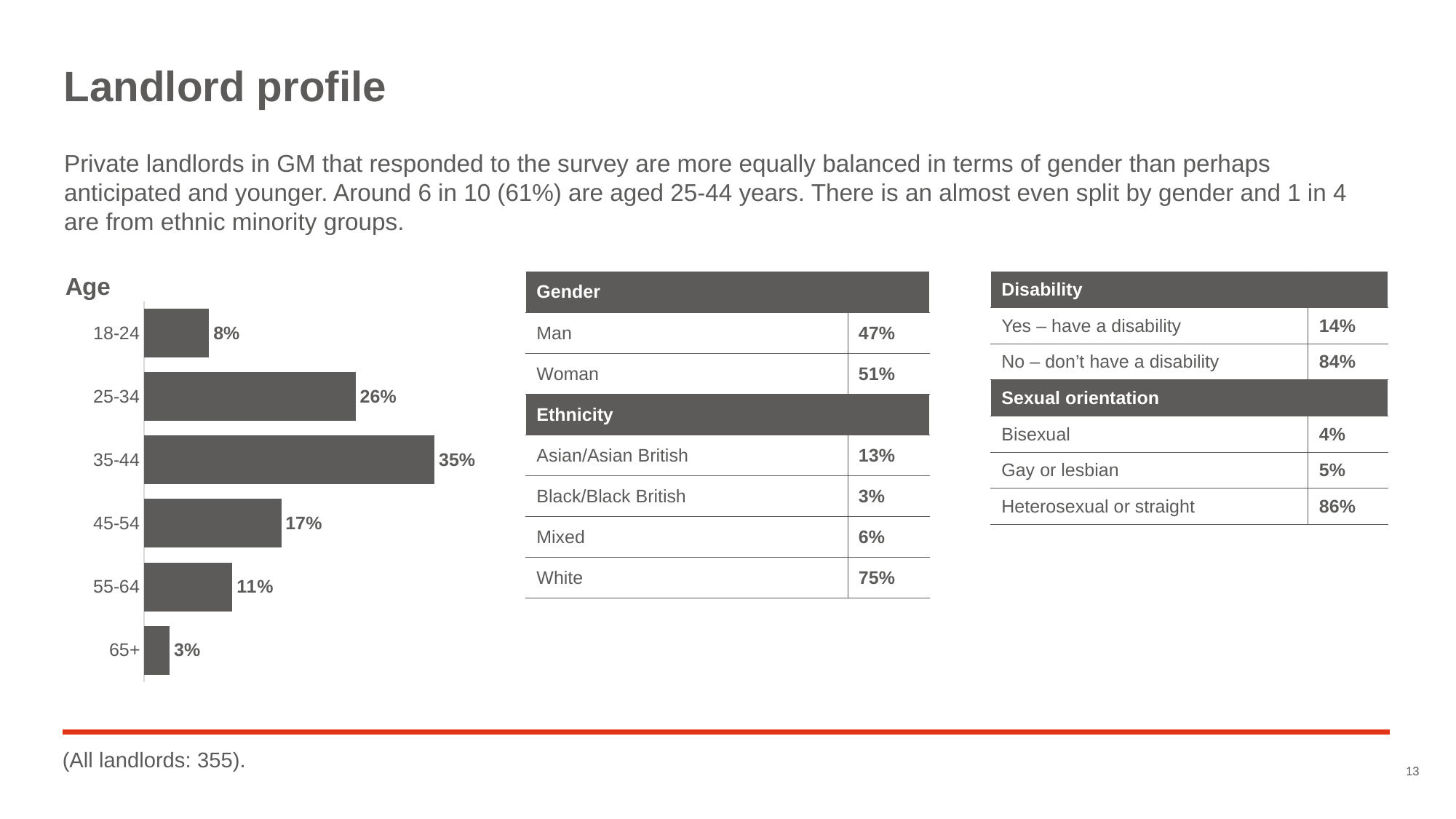
What is the combined value of the 25-34 and 35-44 age groups in the Age chart? 61% What is the difference between the 45-54 and 65+ values in the Age chart? 14% What percentage of landlords are aged 35-44 in the Age chart? 35% What percentage of landlords are aged 55-64 in the Age chart? 11% In the Age chart, which is larger: the value for 25-34 or the value for 45-54? 25-34 What is the value for the 18-24 age group in the Age chart? 8% Which age group has the lowest value in the Age chart? 65+ What is the title of the bar chart on the slide? Age Which age group has the highest value in the Age chart? 35-44 What kind of chart is the Age chart? Bar chart What is the difference between the 35-44 and 25-34 values in the Age chart? 9% How many age groups are shown in the Age chart? 6